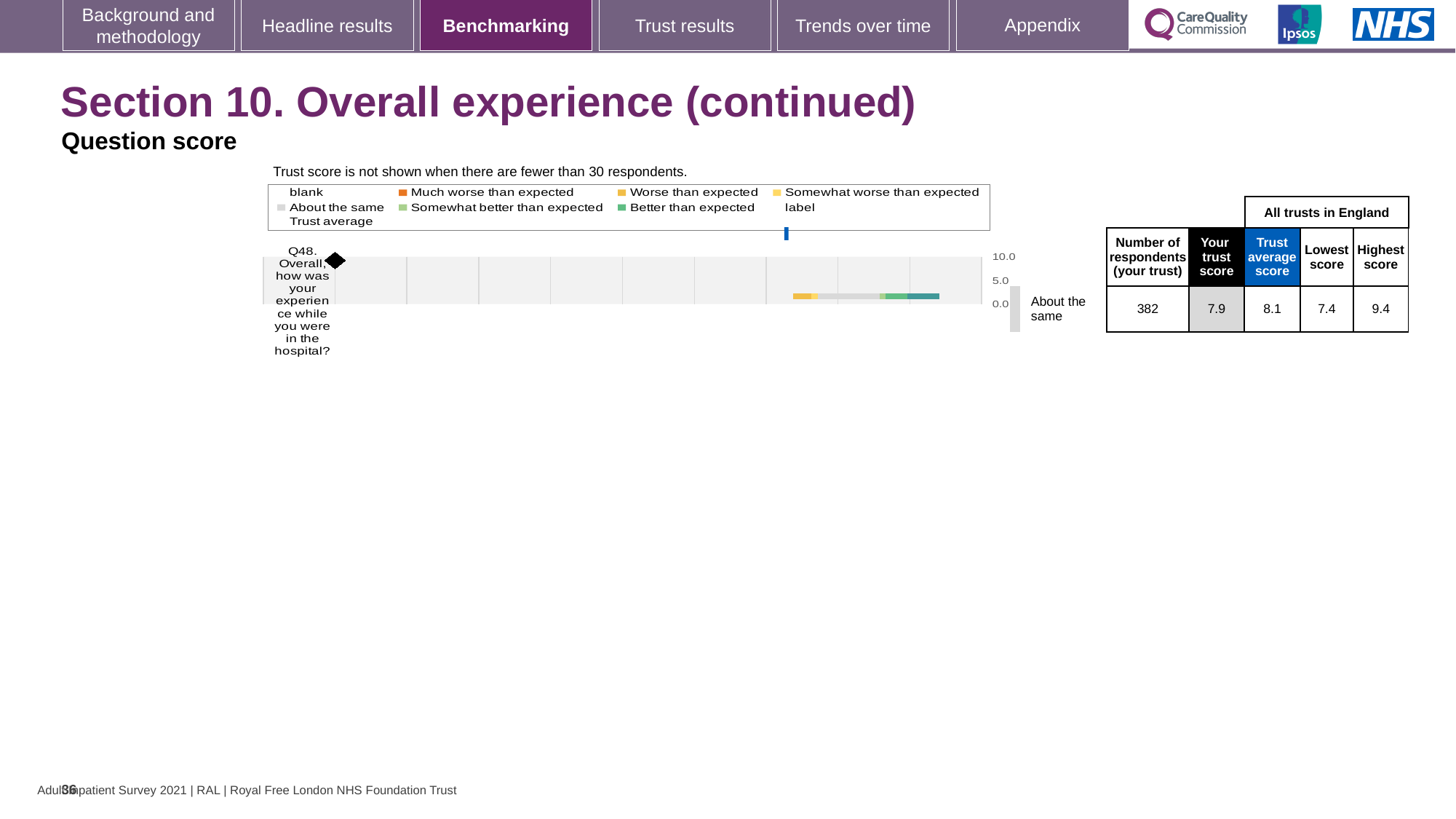
What is the difference between the trust average score and the trust's own score for Q48? 0.2 What is the trust score for Q48 (Overall, how was your experience while you were in the hospital?)? 7.9 How many questions are plotted on the chart? 1 How many respondents from the trust answered Q48? 382 Is the trust score for Q48 greater or less than 5.0? greater Which is larger for Q48: the trust's own score or the trust average score? Trust average score What is the highest score among all trusts in England for Q48? 9.4 What is the lowest score among all trusts in England for Q48? 7.4 What is the difference between the highest and lowest scores among all trusts in England for Q48? 2.0 What kind of chart is used to show the Q48 benchmarking result? Bar chart What is the trust average score across all trusts in England for Q48? 8.1 How is the trust's result for Q48 categorised relative to what is expected? About the same